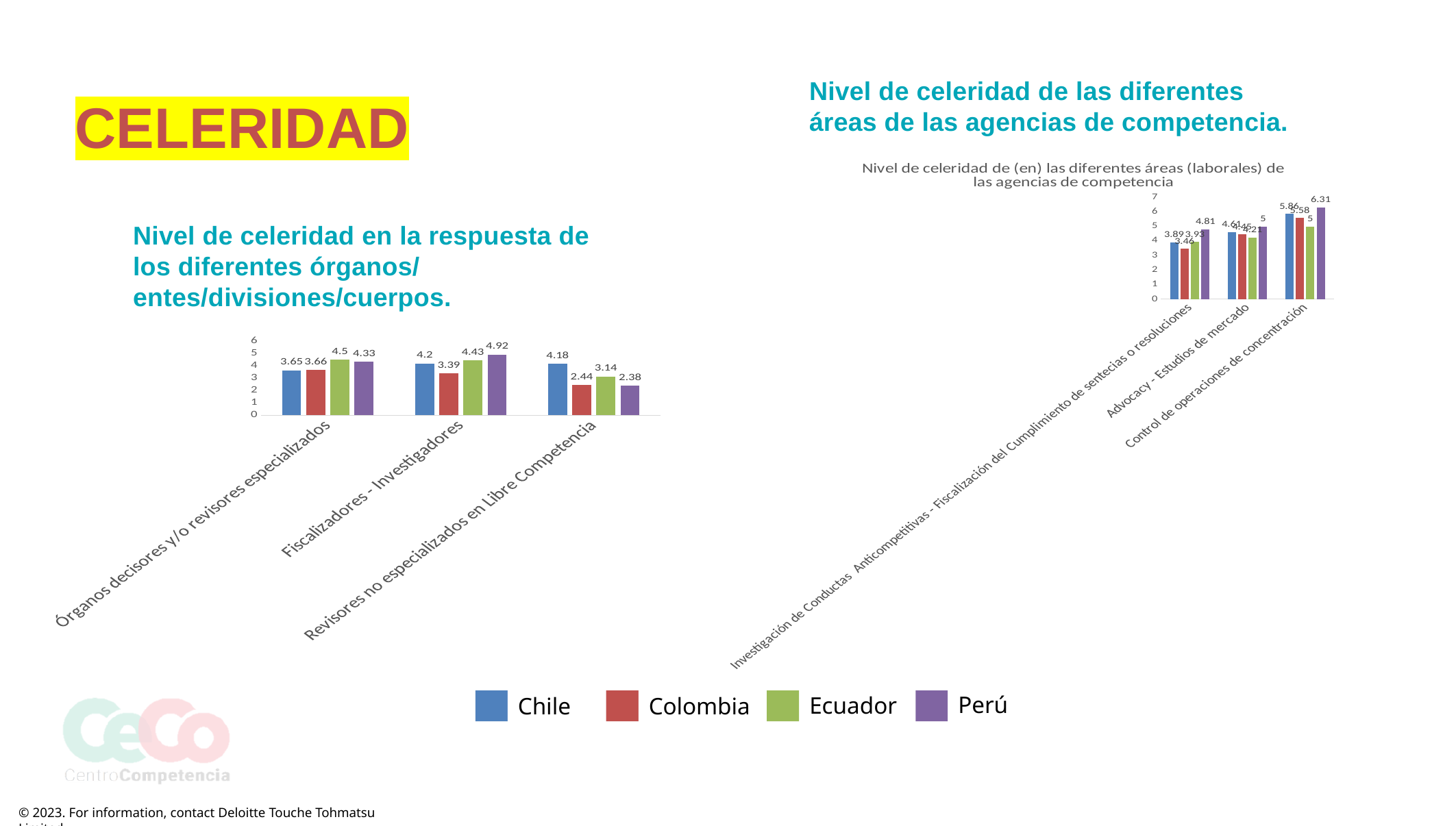
What type of chart is the left chart? Bar chart In the right chart, which country has the highest value in the Control de operaciones de concentración category? Perú In the left chart, is the value for Ecuador in the Órganos decisores y/o revisores especializados category larger than the value for Perú in that category? Yes In the right chart, what is the value for Colombia in the Investigación de Conductas Anticompetitivas category? 3.46 In the right chart, what is the value for Perú in the Control de operaciones de concentración category? 6.31 In the right chart, what is the difference between Chile and Ecuador in the Control de operaciones de concentración category? 0.86 In the left chart, what is the value for Perú in the Fiscalizadores - Investigadores category? 4.92 In the left chart, what is the difference between Chile and Colombia in the Revisores no especializados en Libre Competencia category? 1.74 How many series does the legend list? 4 In the left chart, which country has the lowest value in the Revisores no especializados en Libre Competencia category? Perú In the left chart, what is the value for Colombia in the Revisores no especializados en Libre Competencia category? 2.44 In the left chart, which country has the highest value in the Fiscalizadores - Investigadores category? Perú